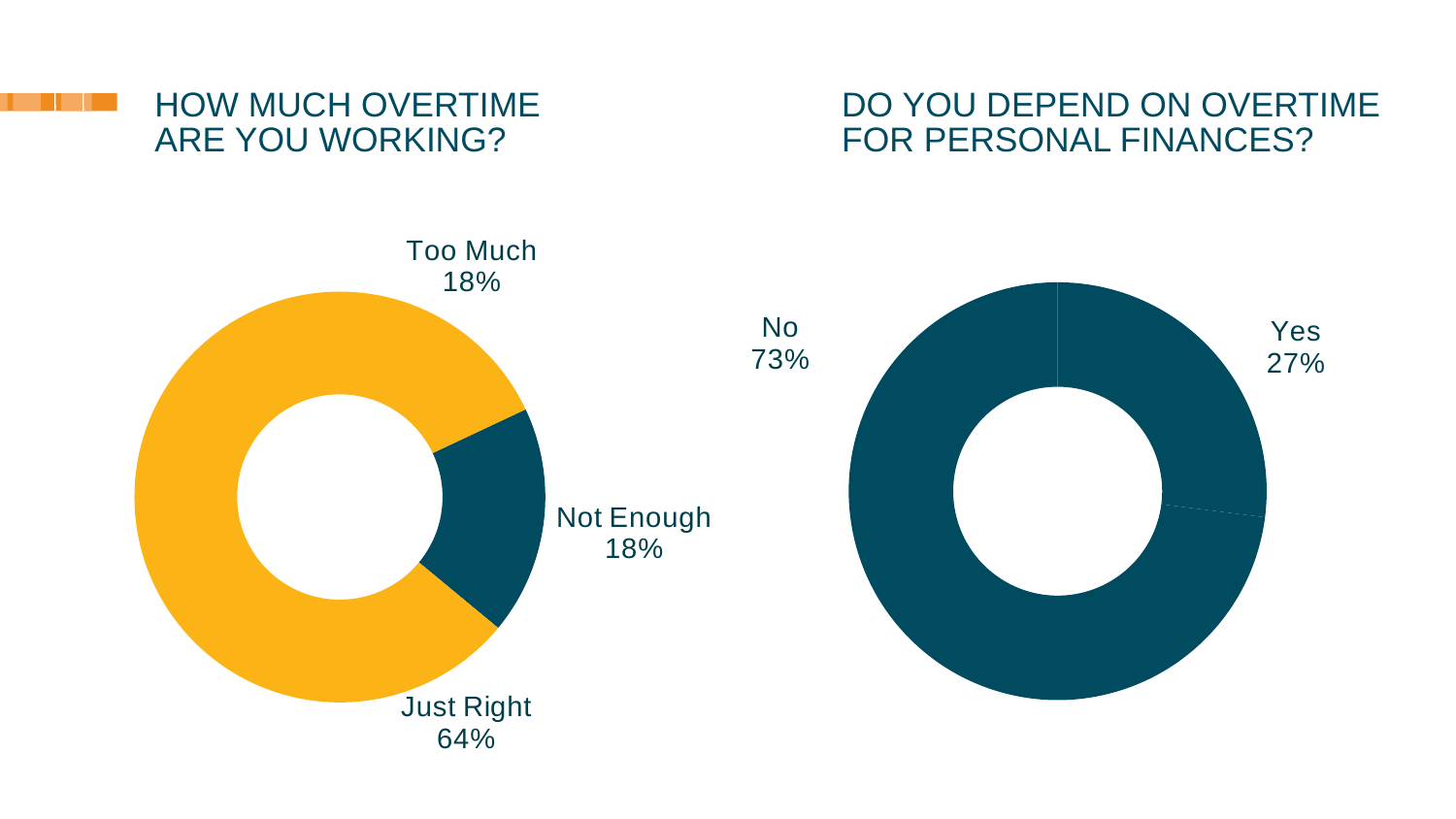
In the 'Do you depend on overtime for personal finances?' chart, which response has the smallest share? Yes In the 'Do you depend on overtime for personal finances?' chart, what percentage answered 'No'? 73% In the 'How much overtime are you working?' chart, what is the difference between the 'Just Right' and 'Not Enough' shares? 46 percentage points In the 'How much overtime are you working?' chart, what colour is the 'Not Enough' segment? Dark teal In the 'How much overtime are you working?' chart, what percentage answered 'Just Right'? 64% In the 'Do you depend on overtime for personal finances?' chart, what is the difference between the 'No' and 'Yes' shares? 46 percentage points In the 'How much overtime are you working?' chart, what percentage answered 'Too Much'? 18% In the 'How much overtime are you working?' chart, which is larger: 'Just Right' or 'Too Much'? Just Right How many categories are shown in the 'How much overtime are you working?' chart? 3 In the 'How much overtime are you working?' chart, which response has the largest share? Just Right In the 'Do you depend on overtime for personal finances?' chart, what percentage answered 'Yes'? 27% What type of chart is used on the right side of the slide, titled 'Do you depend on overtime for personal finances?'? Doughnut (pie) chart